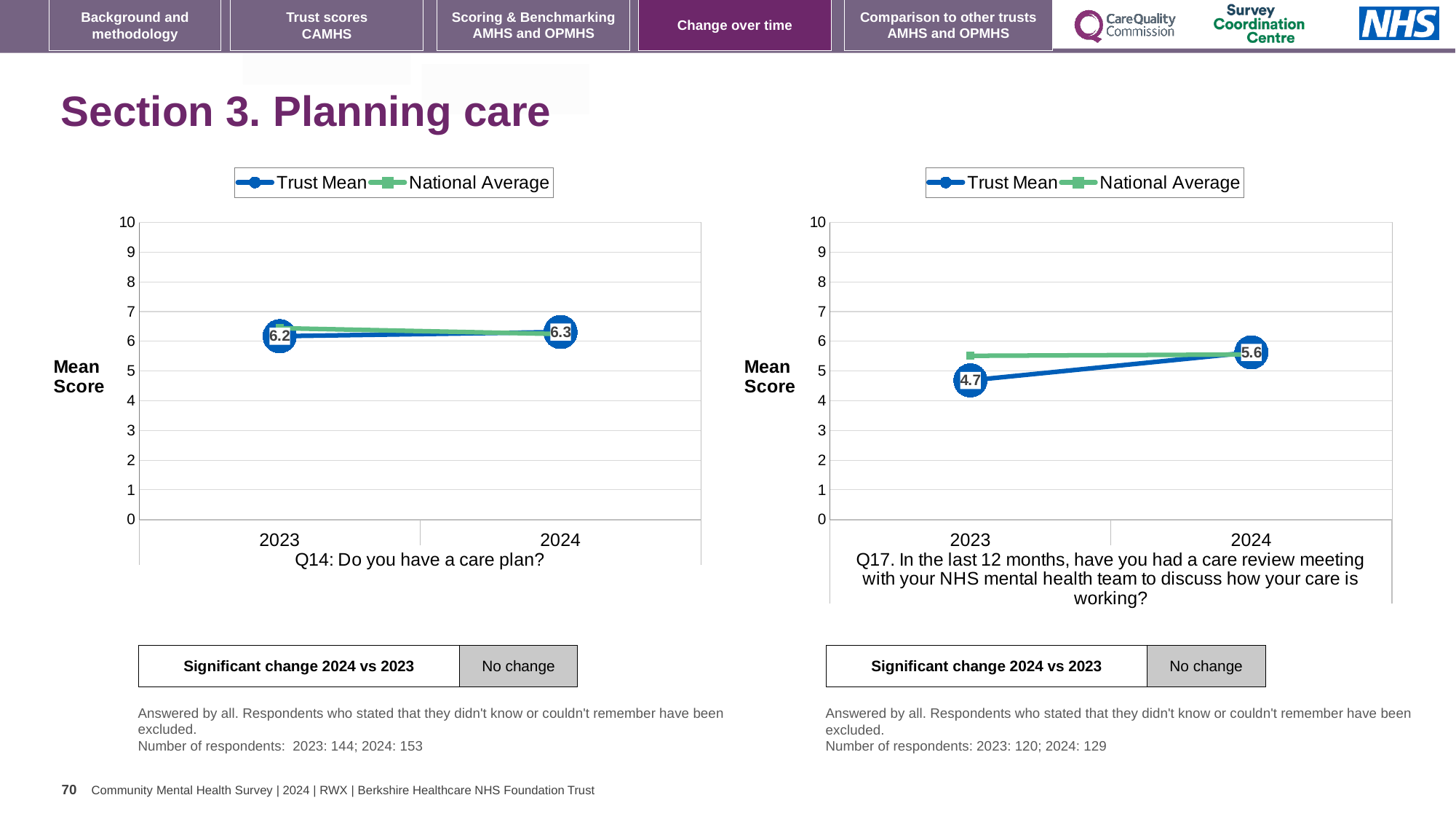
In the Q14 chart (left), what is the Trust Mean score for 2023? 6.2 In the Q14 chart (left), is the National Average for 2023 greater or less than 7? less In the Q17 chart (right), which year has the higher Trust Mean, 2023 or 2024? 2024 In the Q17 chart (right), what is the Trust Mean score for 2024? 5.6 In the Q14 chart (left), what is the Trust Mean score for 2024? 6.3 In the Q17 chart (right), by how much did the Trust Mean increase from 2023 to 2024? 0.9 In the Q17 chart (right), does the Trust Mean rise or fall from 2023 to 2024? rise What kind of chart is the Q14 chart on the left? line chart In the Q17 chart (right), is the National Average for 2023 greater or less than 5? greater In the Q17 chart (right), what is the Trust Mean score for 2023? 4.7 How many series does the legend of the Q17 chart (right) list? 2 How many years are plotted on the x axis of the Q14 chart (left)? 2